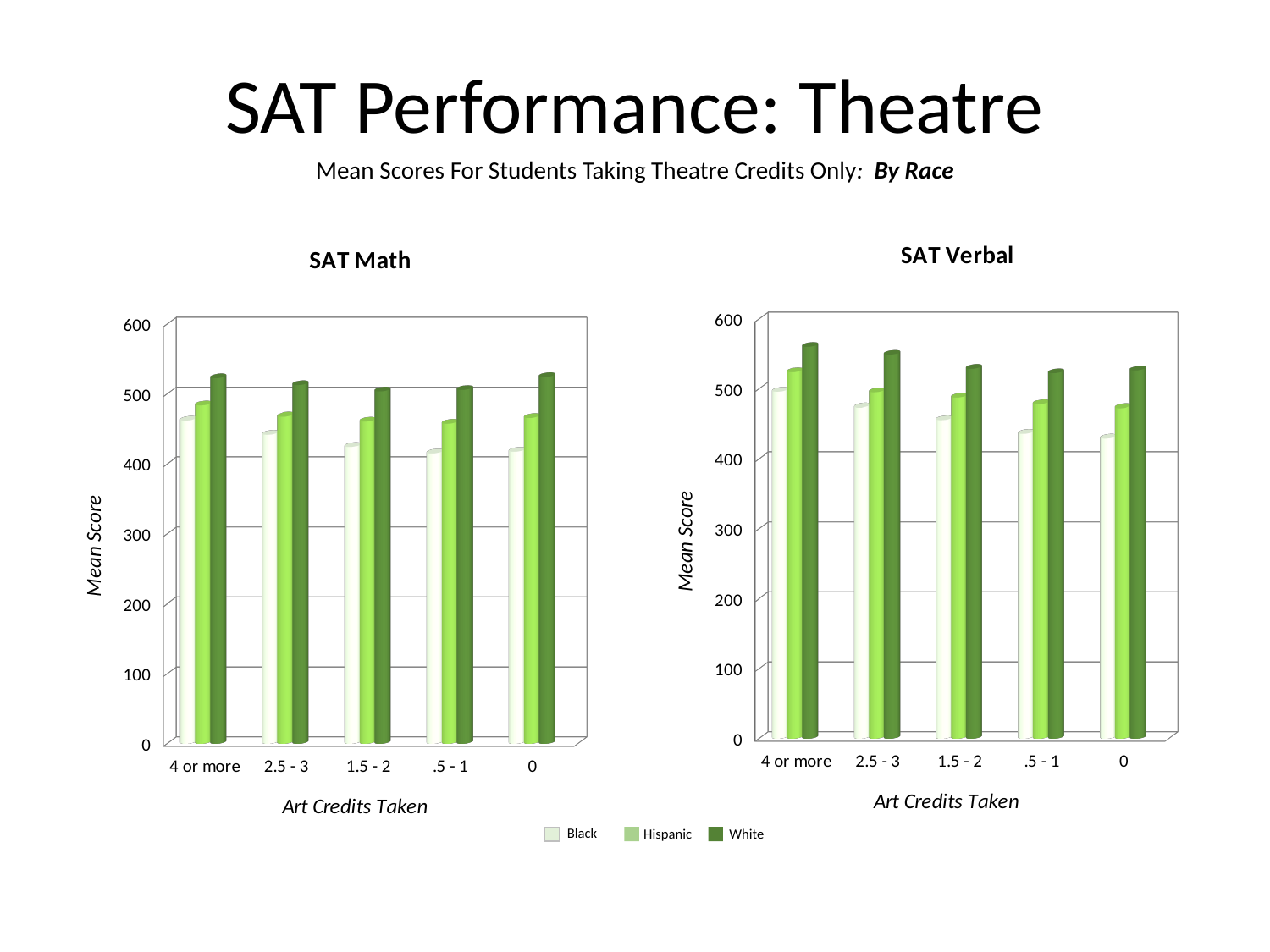
How many categories are shown on the x axis of the SAT Verbal chart? 5 In the SAT Math chart, is the value for Black students with 0 art credits greater or less than 500? less How many series does the legend list for the charts? 3 In the SAT Verbal chart, is the value for Black students with 0 art credits greater or less than 500? less What is the label on the x axis of the SAT Math chart? Art Credits Taken In the SAT Verbal chart, is the value for White students with 4 or more art credits greater or less than 500? greater In the SAT Verbal chart, which series has the lowest bar in the 4 or more category? Black In the SAT Verbal chart, for the 0 category, which is larger: the Hispanic bar or the Black bar? Hispanic In the SAT Math chart, for the 4 or more category, which is larger: the White bar or the Black bar? White In the SAT Verbal chart, do the Black bars rise or fall moving from 4 or more to 0 art credits? fall What kind of chart is the SAT Math chart? bar chart